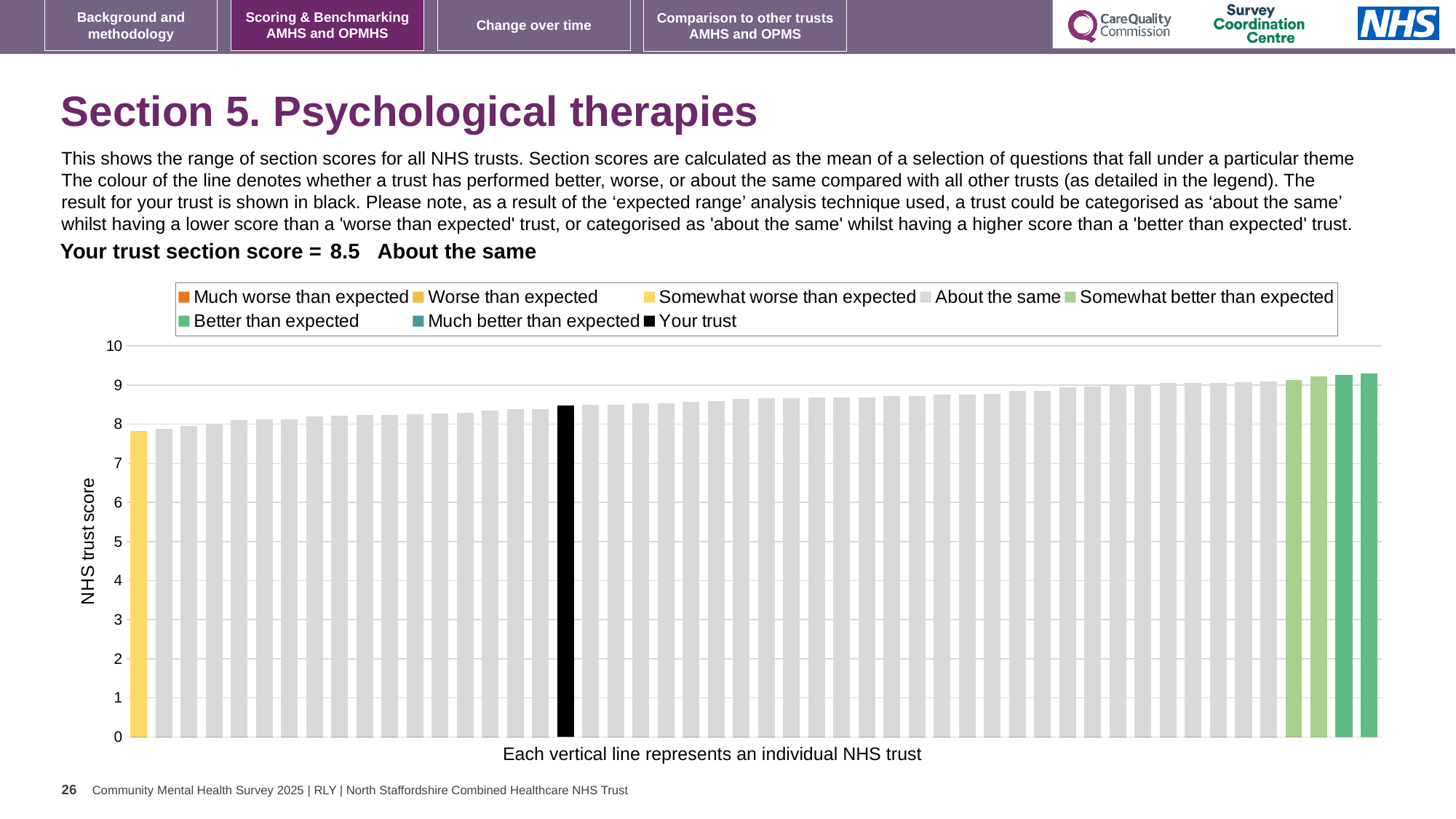
Is the value of the rightmost bar greater or less than 9? greater Is the value of the black 'Your trust' bar greater or less than 9? less What is the label on the vertical axis of the chart? NHS trust score Is the value of the black 'Your trust' bar greater or less than 8? greater How many bars are coloured green (better than expected categories)? 4 Which category is your trust placed in according to the text above the chart? About the same Do the bar values rise or fall from left to right along the x axis? rise How many entries does the chart legend list? 8 What kind of chart is shown on the slide? bar chart What is the section score for your trust shown on the slide? 8.5 Which bar is taller, the leftmost bar or the rightmost bar? rightmost